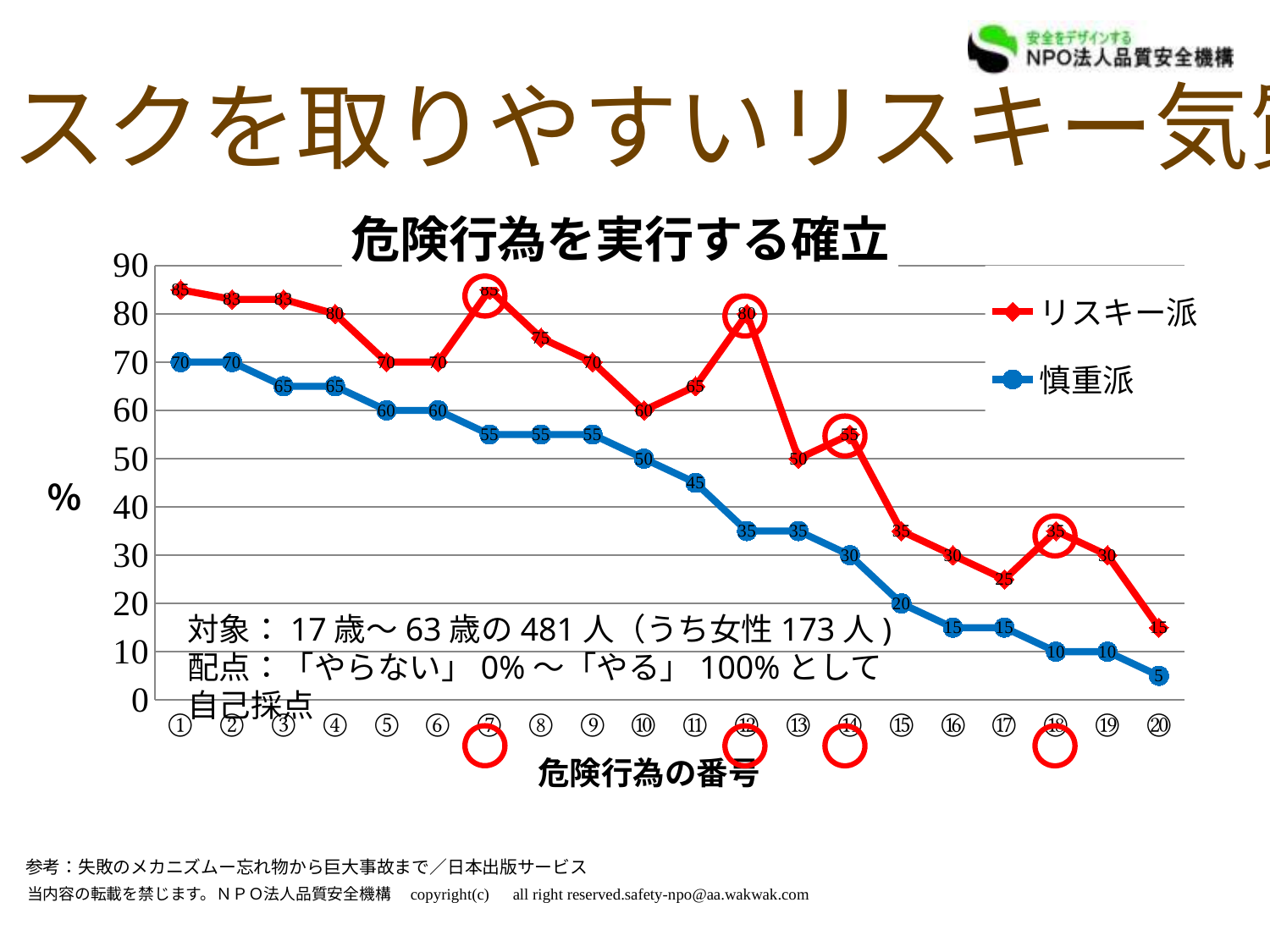
What is the value for 慎重派 at ⑳? 5 What type of chart is shown on the slide? line chart At which 危険行為 number does 慎重派 reach its lowest value? ⑳ What are the two series named in the legend? リスキー派 and 慎重派 Which series has the higher value at ⑦, リスキー派 or 慎重派? リスキー派 Do the values for 慎重派 generally rise or fall from ① to ⑳? fall What is the difference between リスキー派 and 慎重派 at ⑭? 25 What is the value for リスキー派 at ⑫? 80 How many series does the legend list? 2 What is the value for 慎重派 at ①? 70 What is the title of the chart? 危険行為を実行する確立 How many 危険行為 numbers are plotted along the x axis? 20